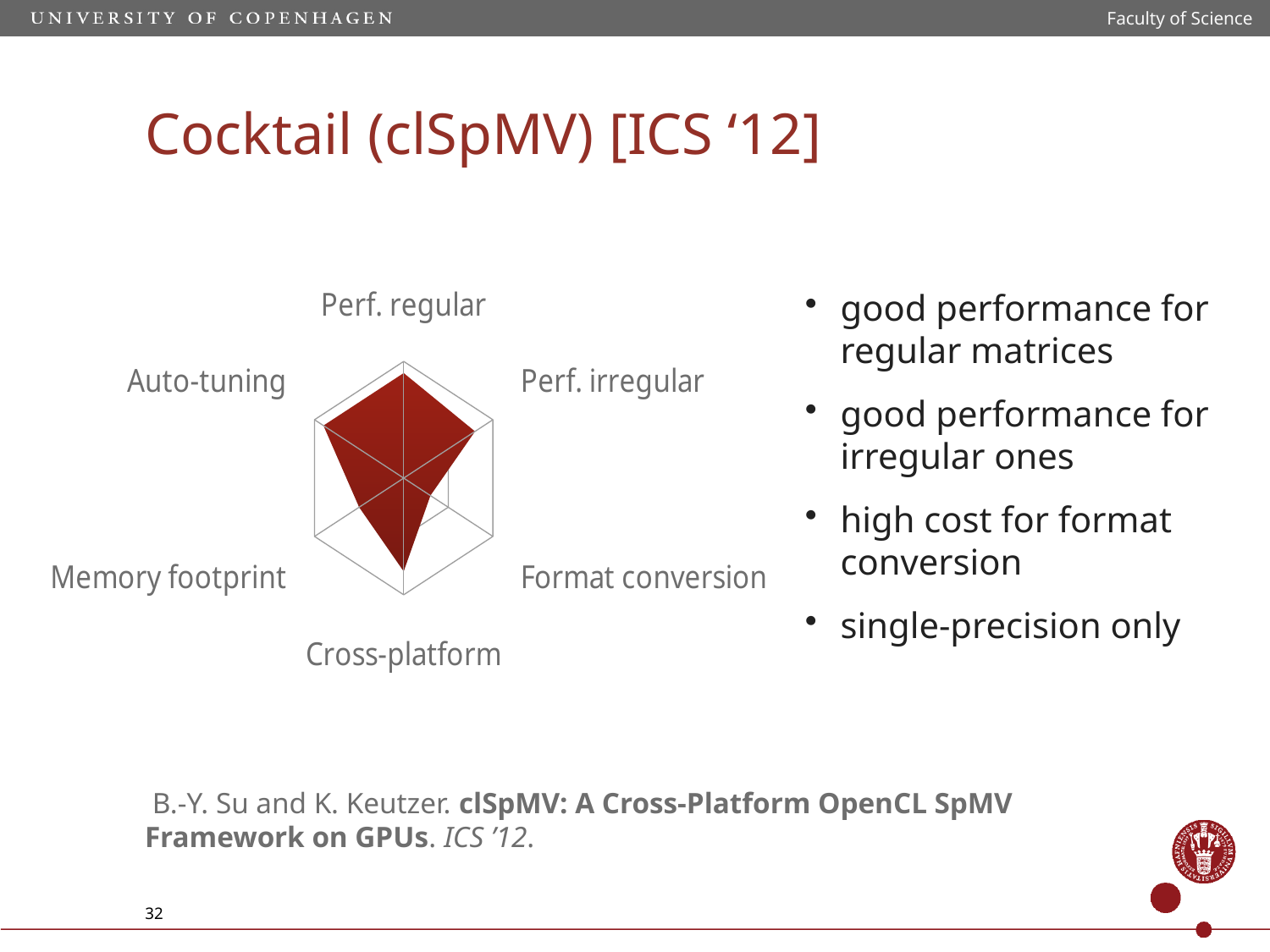
Which category label appears at the bottom of the radar chart? Cross-platform What colour is the filled area of the radar chart? dark red Which is larger on the radar chart, Auto-tuning or Format conversion? Auto-tuning How many axes (categories) does the radar chart have? 6 Does the radar chart's shape reach the outer edge at Perf. irregular? no What kind of chart is shown on the slide? radar chart Which is larger on the radar chart, Cross-platform or Memory footprint? Cross-platform Which is larger on the radar chart, Perf. regular or Format conversion? Perf. regular Which category on the radar chart has the lowest value? Format conversion